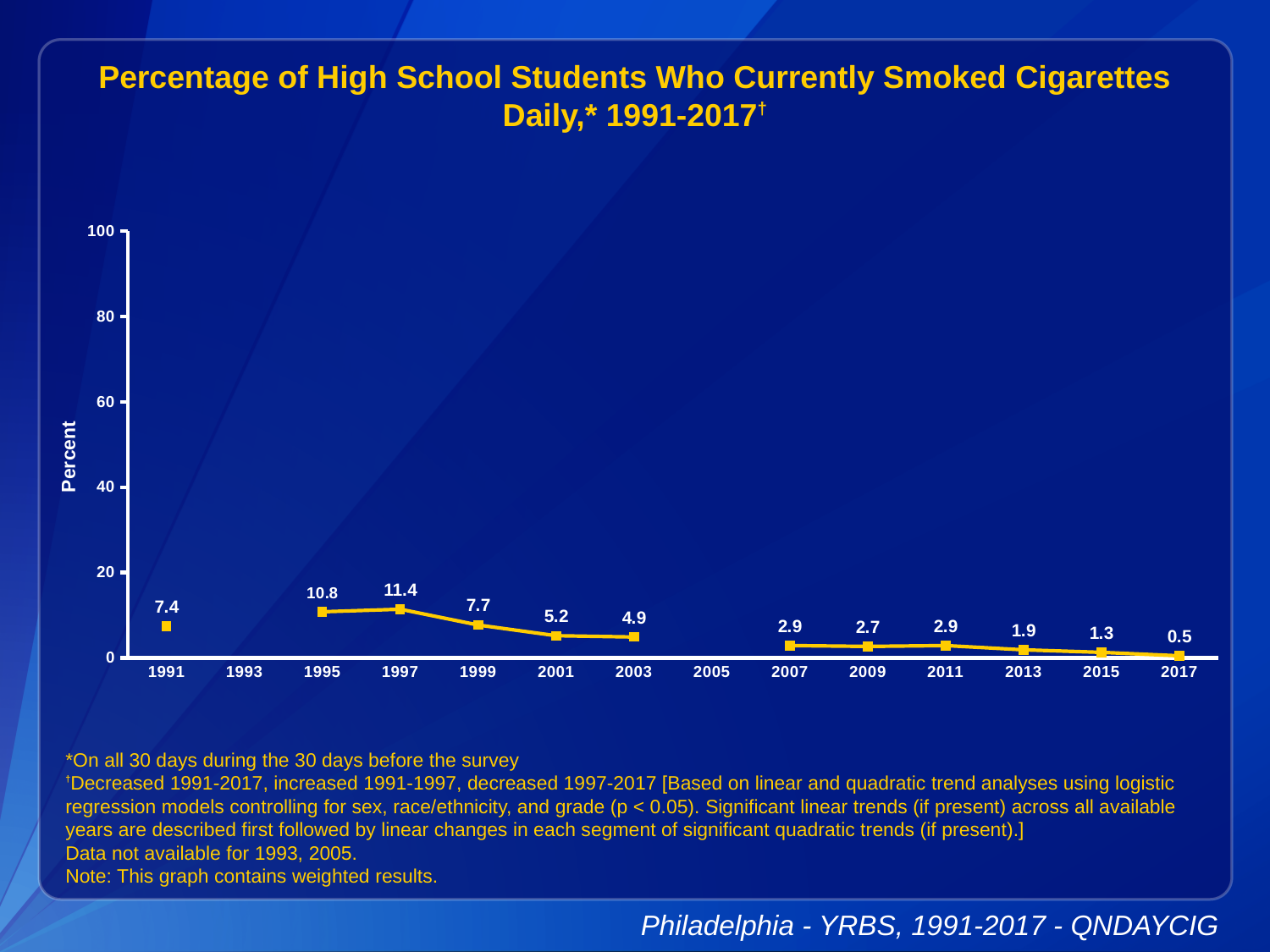
How many years have data points plotted on the chart? 12 What is the label on the y axis? Percent What kind of chart is shown? line chart What value is shown for 2017? 0.5 Do the values rise or fall from 1997 to 2017? fall What was the percentage of high school students who currently smoked cigarettes daily in 1997? 11.4 Which year has the highest percentage? 1997 What value is shown for 1991? 7.4 Which year has the lowest percentage? 2017 Is the value for 1997 greater or less than 20? less What is the difference between the values for 1997 and 2017? 10.9 Which is larger, the value for 1995 or the value for 1999? 1995